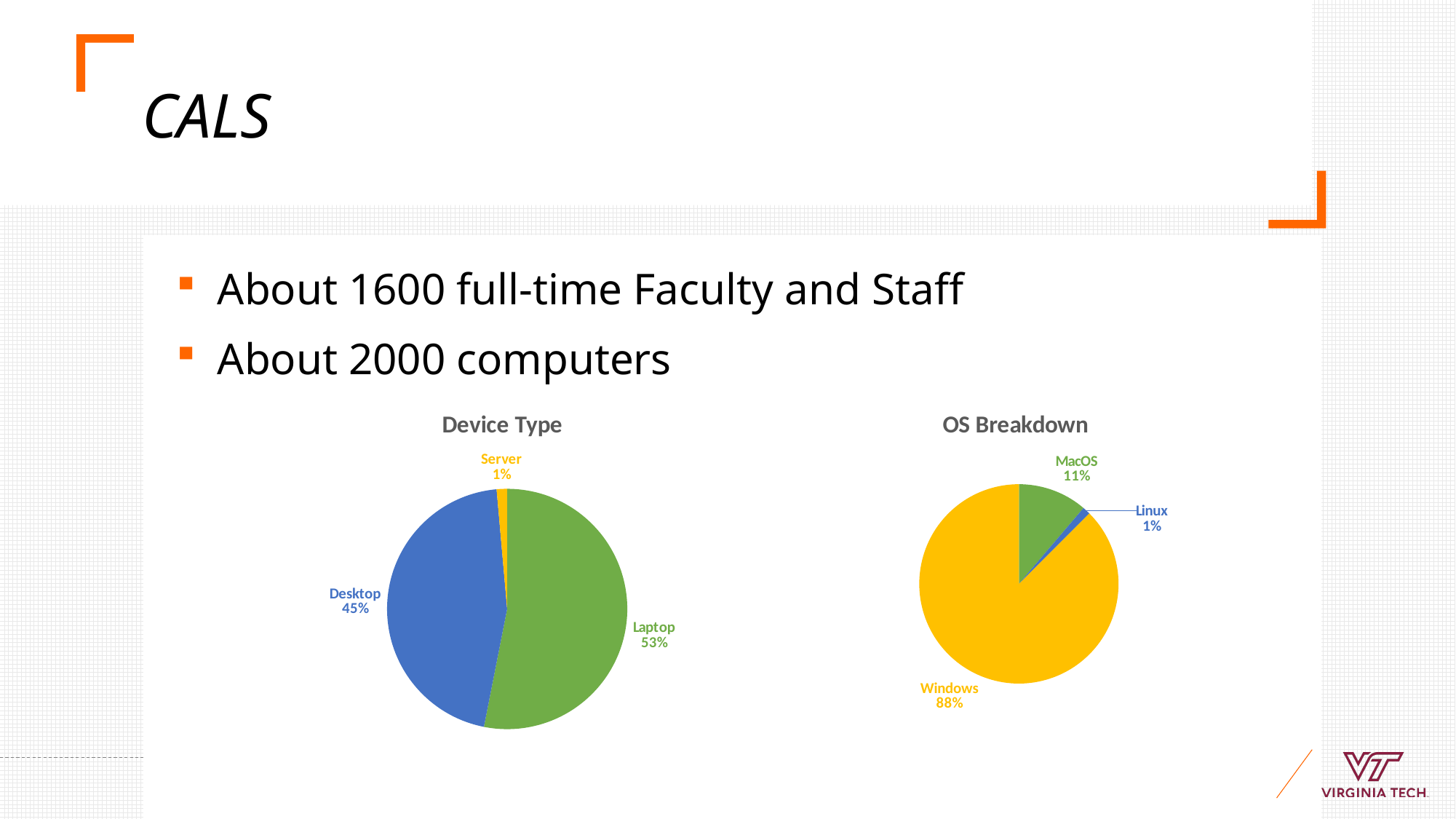
In the Device Type chart, what percentage is shown for Server? 1% What kind of chart is the OS Breakdown chart? Pie chart In the OS Breakdown chart, what percentage is shown for Windows? 88% In the OS Breakdown chart, what is the difference in percentage points between Windows and MacOS? 77 In the Device Type chart, how many categories are shown? 3 In the Device Type chart, what colour is the Desktop slice? Blue In the Device Type chart, what share of devices are laptops? 53% In the OS Breakdown chart, what percentage is shown for MacOS? 11% In the Device Type chart, which category has the smallest slice? Server In the Device Type chart, what percentage is shown for Desktop? 45% In the OS Breakdown chart, which operating system has the smallest share? Linux In the Device Type chart, which category has the largest slice? Laptop